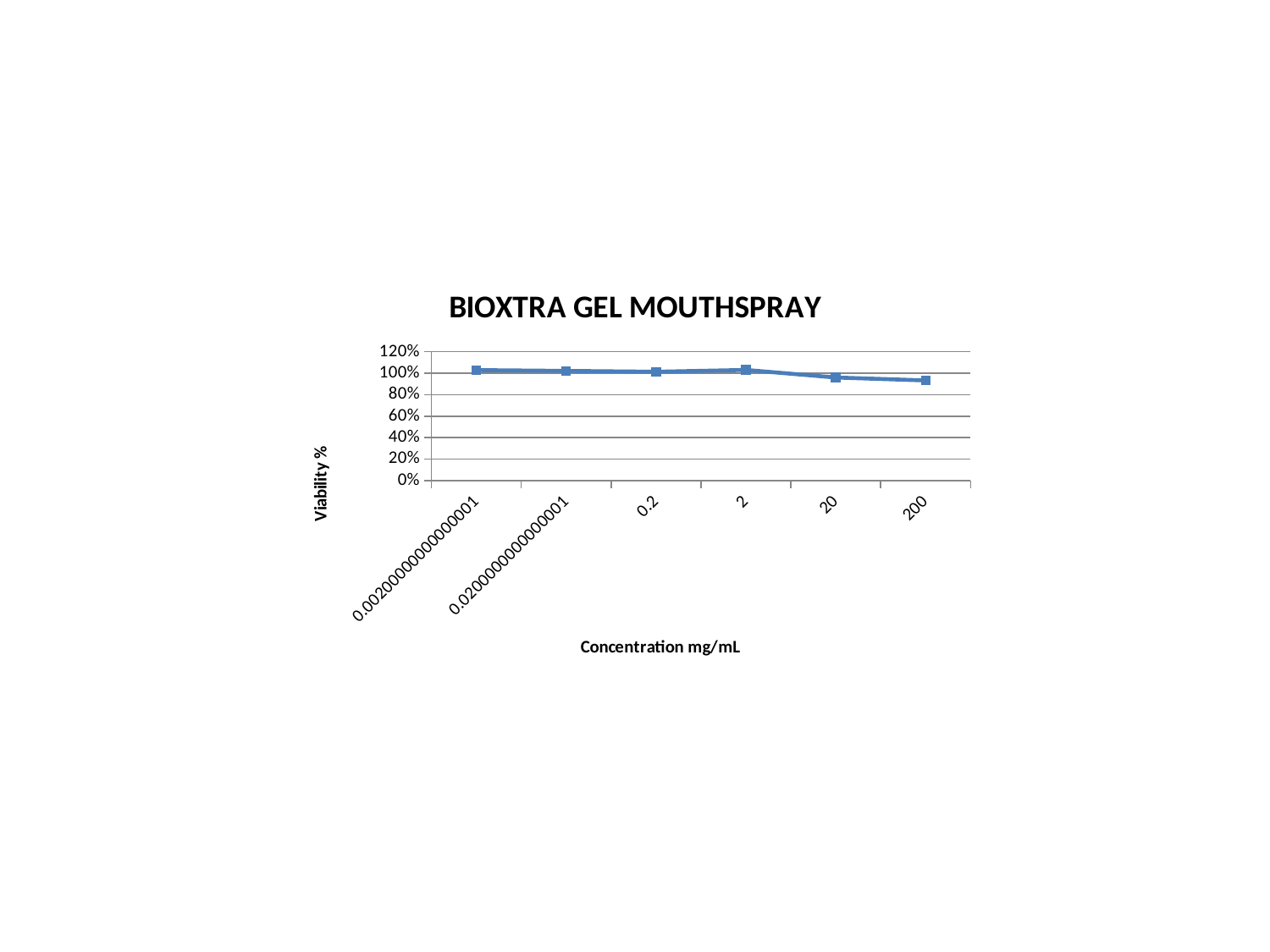
What kind of chart is shown on the slide? line chart What is the title of the chart? BIOXTRA GEL MOUTHSPRAY Does viability rise or fall overall as concentration increases along the x axis? fall Which has the higher viability, a concentration of 0.2 or a concentration of 200? 0.2 Which concentration has the lowest viability? 200 Is the viability value at a concentration of 200 greater or less than 100%? less Is the viability value at a concentration of 2 greater or less than 80%? greater Is the viability value at a concentration of 0.2 greater or less than 40%? greater What is the label of the x axis? Concentration mg/mL How many concentration points are plotted on the chart? 6